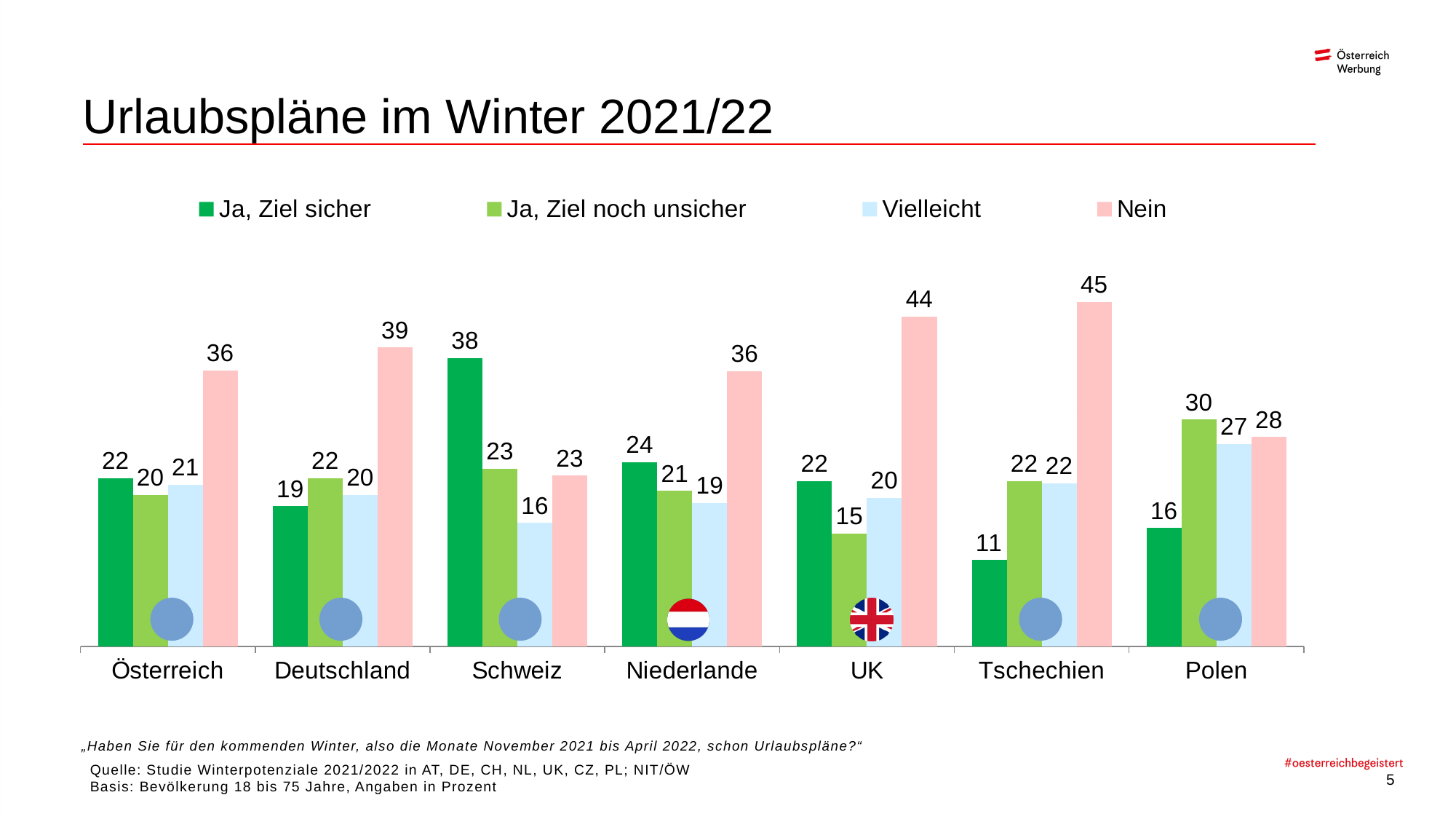
What is the title of the slide? Urlaubspläne im Winter 2021/22 What kind of chart is shown on the slide? Bar chart What is the value for "Vielleicht" for Polen? 27 What is the value for "Nein" for Tschechien? 45 What is the value for "Ja, Ziel sicher" for Schweiz? 38 How many series does the legend list? 4 Which country has the lowest value for "Ja, Ziel sicher"? Tschechien How many countries are shown on the x axis? 7 Which legend entry is shown in pink? Nein What is the difference between the "Nein" values for UK and Österreich? 8 Which is larger: "Ja, Ziel noch unsicher" for Polen or for Deutschland? Polen Which country has the highest value for "Nein"? Tschechien